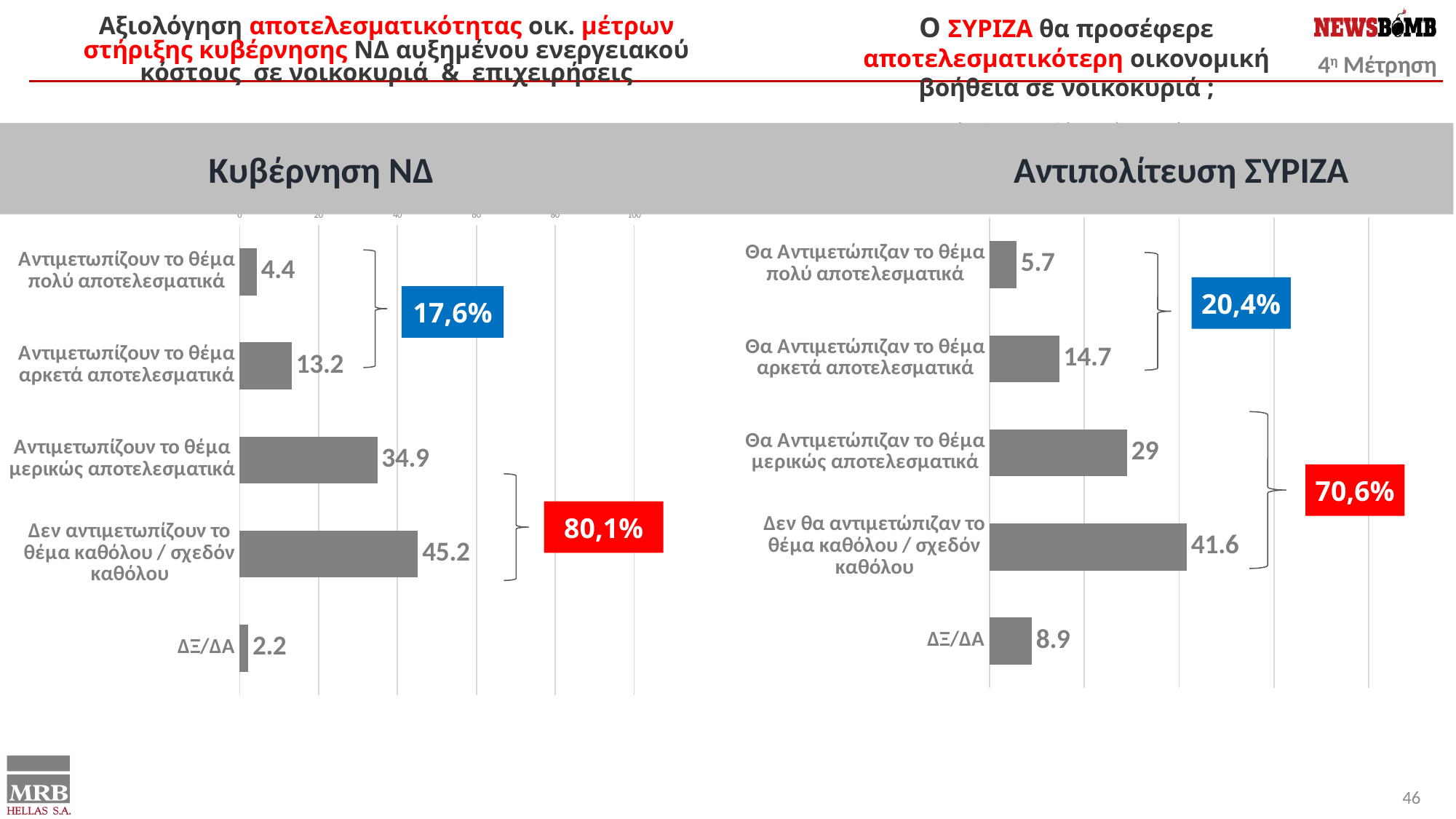
In the "Αντιπολίτευση ΣΥΡΙΖΑ" chart, what is the value for "ΔΞ/ΔΑ"? 8.9 In the "Κυβέρνηση ΝΔ" chart, what is the value for "Αντιμετωπίζουν το θέμα πολύ αποτελεσματικά"? 4.4 In the "Αντιπολίτευση ΣΥΡΙΖΑ" chart, what is the value for "Θα Αντιμετώπιζαν το θέμα μερικώς αποτελεσματικά"? 29 How many categories are shown in the "Κυβέρνηση ΝΔ" chart? 5 Which is larger: the "ΔΞ/ΔΑ" value in the "Κυβέρνηση ΝΔ" chart or the "ΔΞ/ΔΑ" value in the "Αντιπολίτευση ΣΥΡΙΖΑ" chart? Αντιπολίτευση ΣΥΡΙΖΑ In the "Κυβέρνηση ΝΔ" chart, which category has the highest value? Δεν αντιμετωπίζουν το θέμα καθόλου / σχεδόν καθόλου What kind of chart is the "Αντιπολίτευση ΣΥΡΙΖΑ" chart? Bar chart In the "Αντιπολίτευση ΣΥΡΙΖΑ" chart, which category has the lowest value? Θα Αντιμετώπιζαν το θέμα πολύ αποτελεσματικά In the "Αντιπολίτευση ΣΥΡΙΖΑ" chart, what is the difference between "Δεν θα αντιμετώπιζαν το θέμα καθόλου / σχεδόν καθόλου" and "Θα Αντιμετώπιζαν το θέμα μερικώς αποτελεσματικά"? 12.6 In the "Κυβέρνηση ΝΔ" chart, what percentage is shown in the red box? 80,1% In the "Κυβέρνηση ΝΔ" chart, what is the difference between "Δεν αντιμετωπίζουν το θέμα καθόλου / σχεδόν καθόλου" and "Αντιμετωπίζουν το θέμα μερικώς αποτελεσματικά"? 10.3 In the "Κυβέρνηση ΝΔ" chart, what is the value for "Δεν αντιμετωπίζουν το θέμα καθόλου / σχεδόν καθόλου"? 45.2